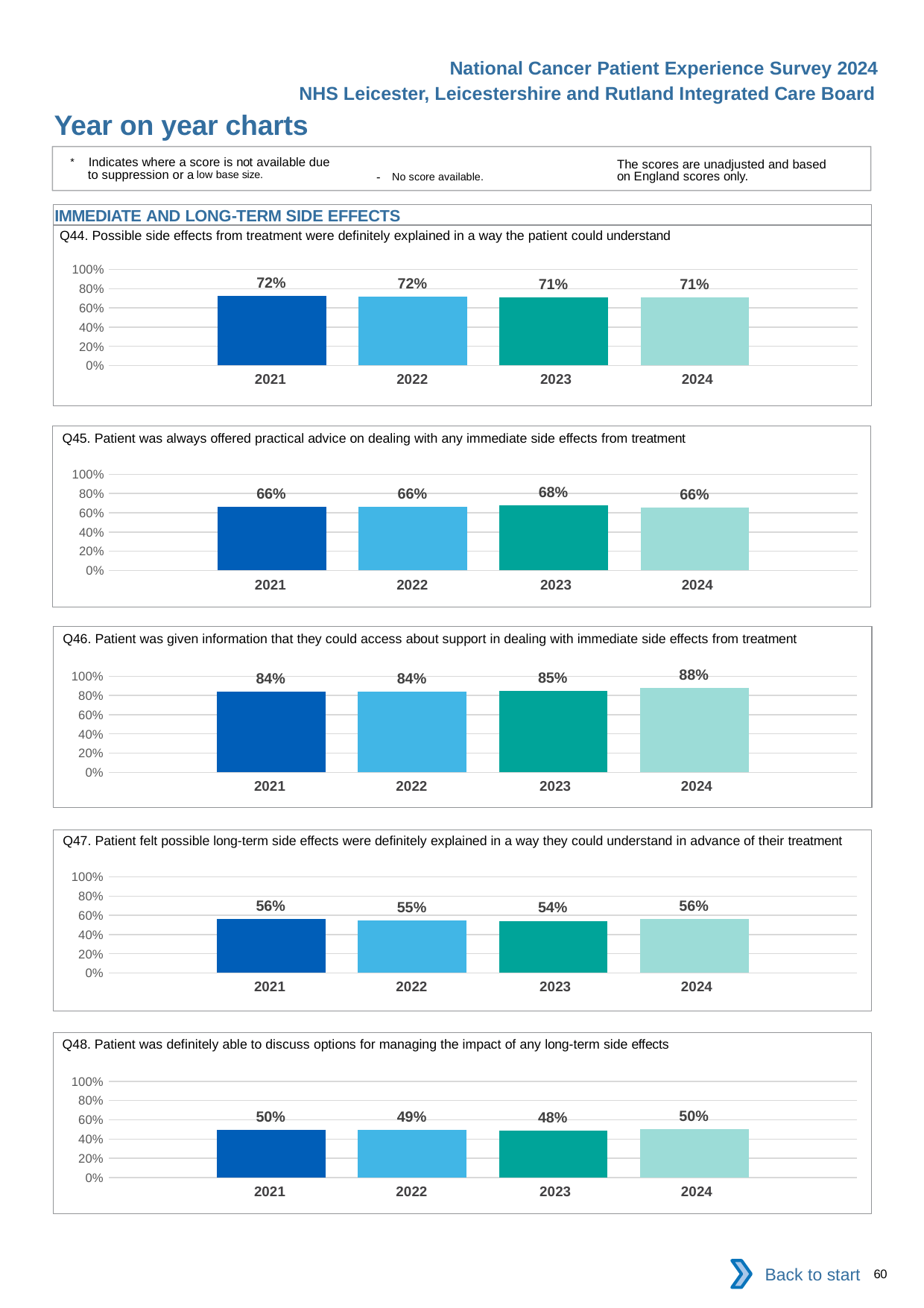
In the Q46 chart, is the value for 2024 greater or less than 80%? greater In the Q45 chart, which year has the highest value? 2023 In the Q46 chart, do the values rise or fall from 2021 to 2024? rise In the Q44 chart, what is the value for 2021? 72% In the Q48 chart, what is the value for 2022? 49% How many years are shown in the Q44 chart? 4 In the Q46 chart, what is the difference between the 2024 and 2021 values? 4% In the Q45 chart, what is the difference between the 2023 and 2024 values? 2% What kind of chart is the Q45 chart? bar chart In the Q47 chart, which is larger, the value for 2021 or the value for 2023? 2021 In the Q47 chart, which year has the lowest value? 2023 In the Q48 chart, is the value for 2023 greater or less than 60%? less